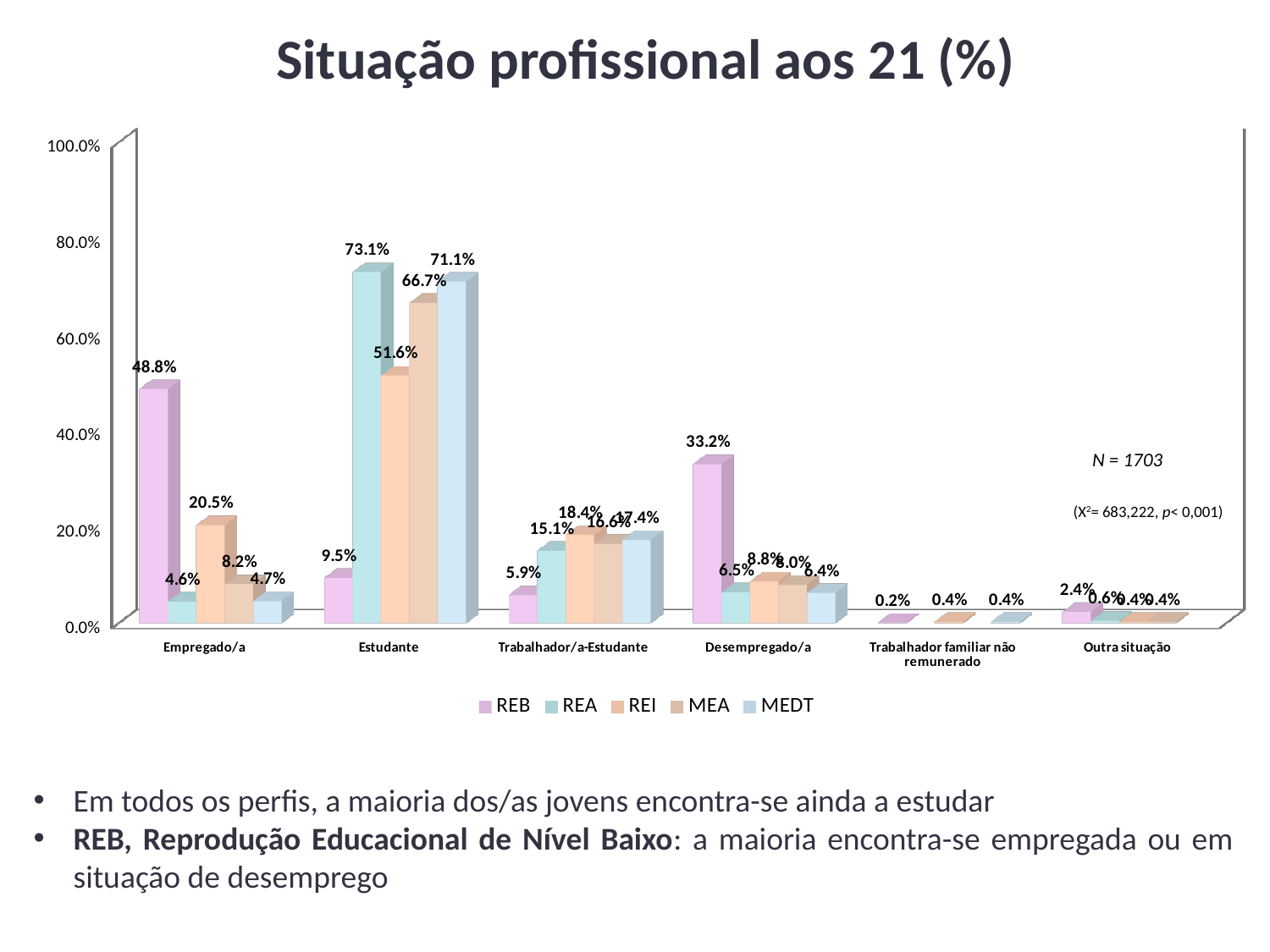
What is the value for REI in the Empregado/a category? 20.5% Which series has the highest value in the Estudante category? REA Which series has the lowest value in the Estudante category? REB Is the value for MEA in the Estudante category greater or less than 60%? greater What type of chart is shown on the slide? Bar chart What is the difference between the REA and REI values in the Estudante category? 21.5 percentage points What is the value for REB in the Empregado/a category? 48.8% How many series does the legend list? 5 What is the value for REB in the Desempregado/a category? 33.2% What is the value for REA in the Estudante category? 73.1% How many categories are shown on the x axis? 6 In the Empregado/a category, which is larger: the REB value or the REI value? REB